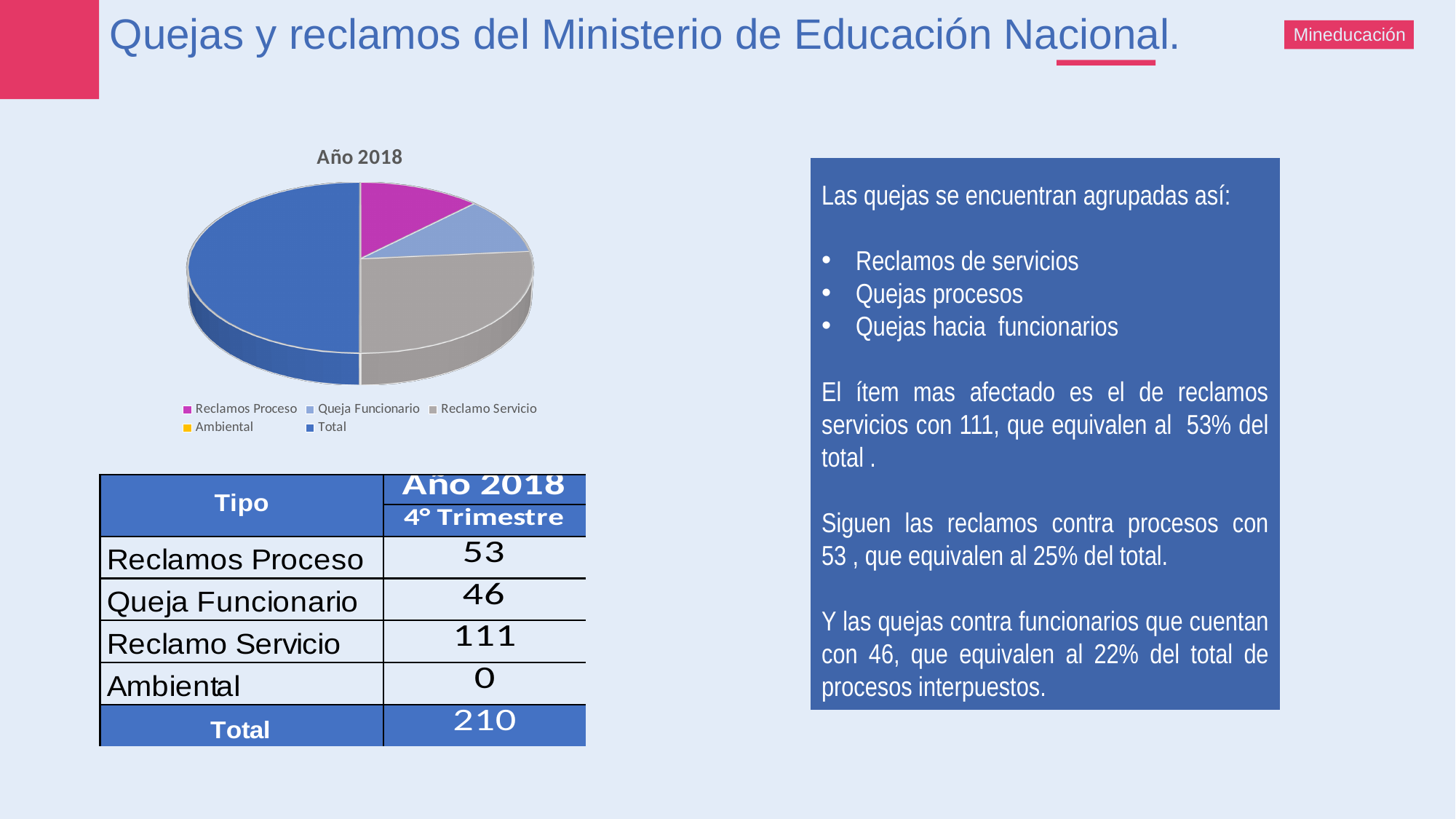
According to the slide, what is the value for Queja Funcionario in the 4° Trimestre of 2018? 46 In the "Año 2018" pie chart, which slice is larger: Reclamo Servicio or Reclamos Proceso? Reclamo Servicio What is the difference between the Reclamo Servicio value (111) and the Reclamos Proceso value (53)? 58 Which legend entry corresponds to the largest slice of the "Año 2018" pie chart? Total How many entries does the legend of the "Año 2018" pie chart list? 5 Which category on the slide has a value of 0 and therefore no visible slice in the pie chart? Ambiental In the "Año 2018" pie chart, which slice is larger: Total or Reclamo Servicio? Total According to the slide, what is the value for Reclamos Proceso in the 4° Trimestre of 2018? 53 What share of the total do the Reclamo Servicio complaints represent, according to the slide? 53% What colour is the Reclamos Proceso slice in the "Año 2018" pie chart? magenta According to the slide, what is the value for Reclamo Servicio in the 4° Trimestre of 2018? 111 What kind of chart is shown under the title "Año 2018"? pie chart